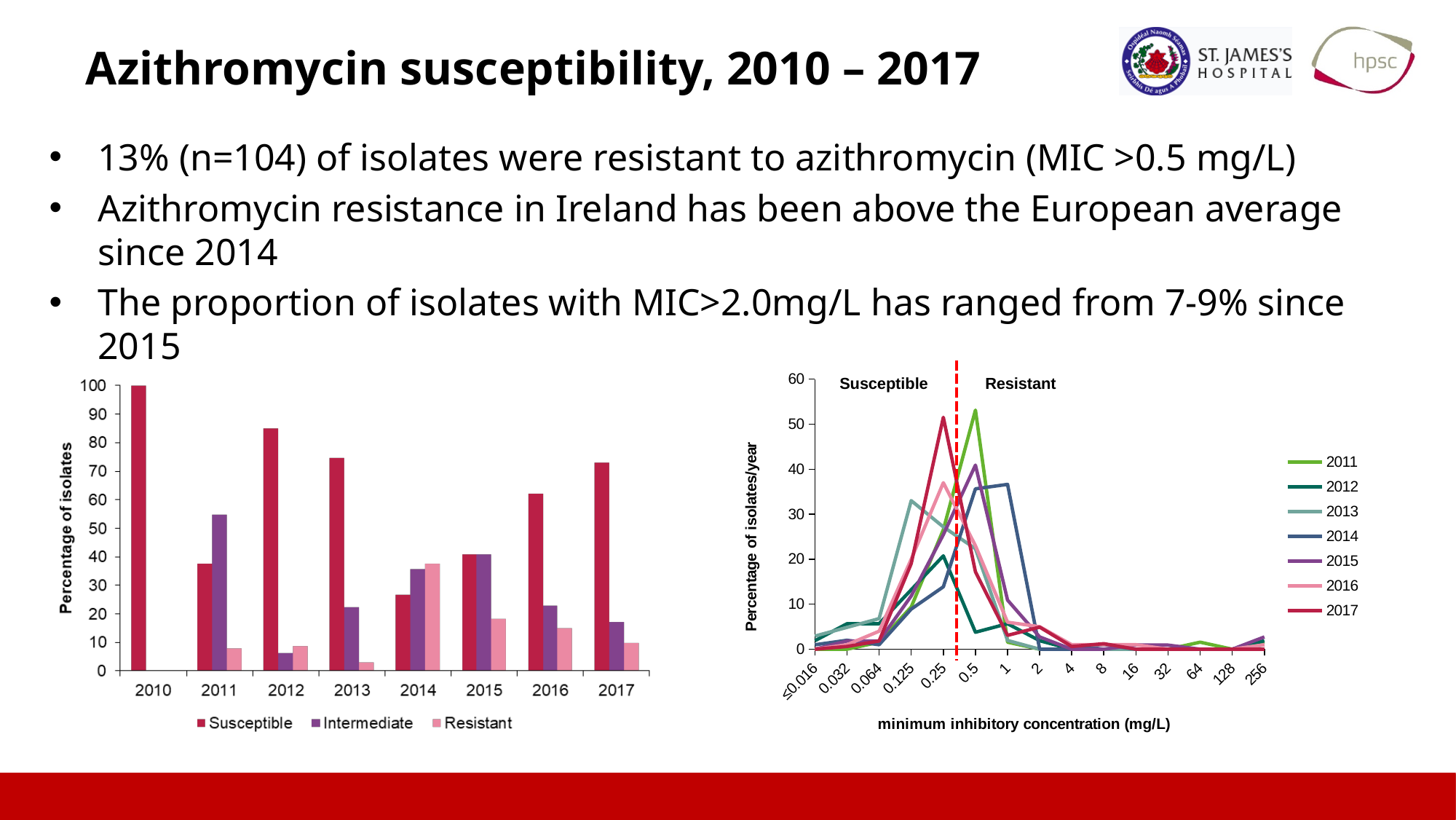
In the right line chart, is the 2011 value at an MIC of 0.5 greater or less than 50? greater In the left bar chart, which year from 2011 onwards has the lowest Resistant percentage? 2013 In the left bar chart, which is larger for 2011: the Susceptible bar or the Intermediate bar? Intermediate In the left bar chart, how many series does the legend list? 3 In the left bar chart, which year has the highest Susceptible percentage? 2010 In the left bar chart, is the Resistant value for 2014 greater or less than 30? greater In the left bar chart, what is the Susceptible percentage for 2010? 100 In the left bar chart, is the Intermediate value for 2011 greater or less than 50? greater In the right line chart, how many years does the legend list? 7 In the left bar chart, how many years are shown on the x axis? 8 What kind of chart is the left chart showing Susceptible, Intermediate and Resistant percentages by year? bar chart What is the x-axis label of the right line chart? minimum inhibitory concentration (mg/L)